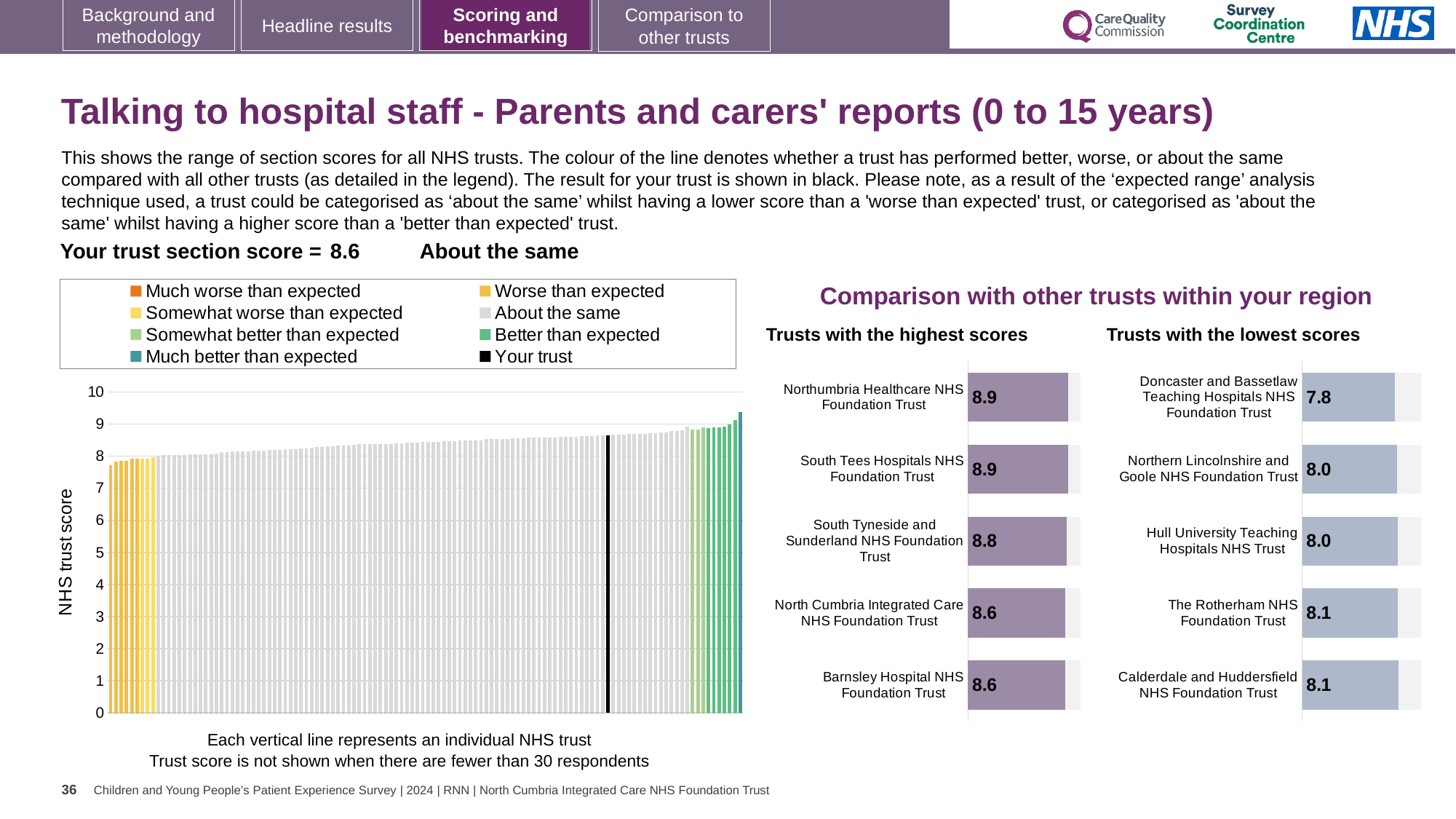
What kind of chart is the large chart on the left showing NHS trust scores? Bar chart How many trusts are shown in the 'Trusts with the lowest scores' chart? 5 In the large chart on the left, is the value for the black bar (Your trust) greater or less than 8? greater In the 'Trusts with the lowest scores' chart, what is the difference between the scores of Calderdale and Huddersfield NHS Foundation Trust and Doncaster and Bassetlaw Teaching Hospitals NHS Foundation Trust? 0.3 In the 'Trusts with the highest scores' chart, what is the difference between the scores of Northumbria Healthcare NHS Foundation Trust and Barnsley Hospital NHS Foundation Trust? 0.3 In the 'Trusts with the highest scores' chart, what is the score for South Tyneside and Sunderland NHS Foundation Trust? 8.8 In the 'Trusts with the lowest scores' chart, which trust has the lowest score? Doncaster and Bassetlaw Teaching Hospitals NHS Foundation Trust How many entries does the legend of the large chart on the left list? 8 In the 'Trusts with the highest scores' chart, what is the score for Northumbria Healthcare NHS Foundation Trust? 8.9 In the 'Trusts with the highest scores' chart, which has the larger score: South Tyneside and Sunderland NHS Foundation Trust or Barnsley Hospital NHS Foundation Trust? South Tyneside and Sunderland NHS Foundation Trust In the large chart on the left, do the trust scores rise or fall from left to right along the x axis? Rise In the 'Trusts with the lowest scores' chart, what is the score for Hull University Teaching Hospitals NHS Trust? 8.0